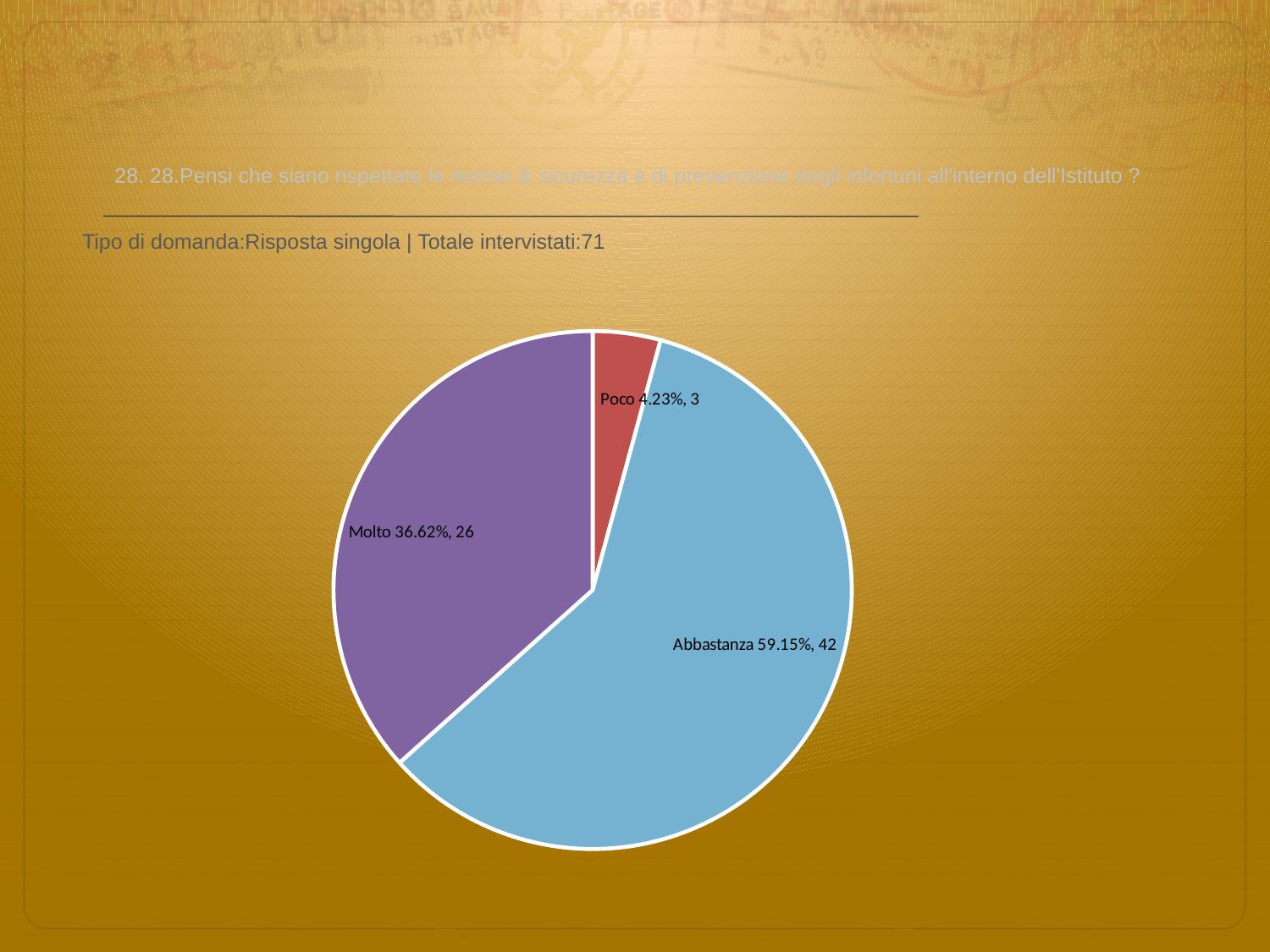
What percentage share does the Abbastanza slice have? 59.15% How many respondents answered Abbastanza? 42 What is the difference in respondent count between Abbastanza and Molto? 16 How many respondents answered Poco? 3 What percentage share does the Molto slice have? 36.62% How many slices does the pie chart have? 3 Which category has the smallest slice? Poco Which category has the largest slice? Abbastanza Which is larger, the Molto slice or the Poco slice? Molto What percentage share does the Poco slice have? 4.23% What kind of chart is shown on the slide? pie chart How many respondents answered Molto? 26